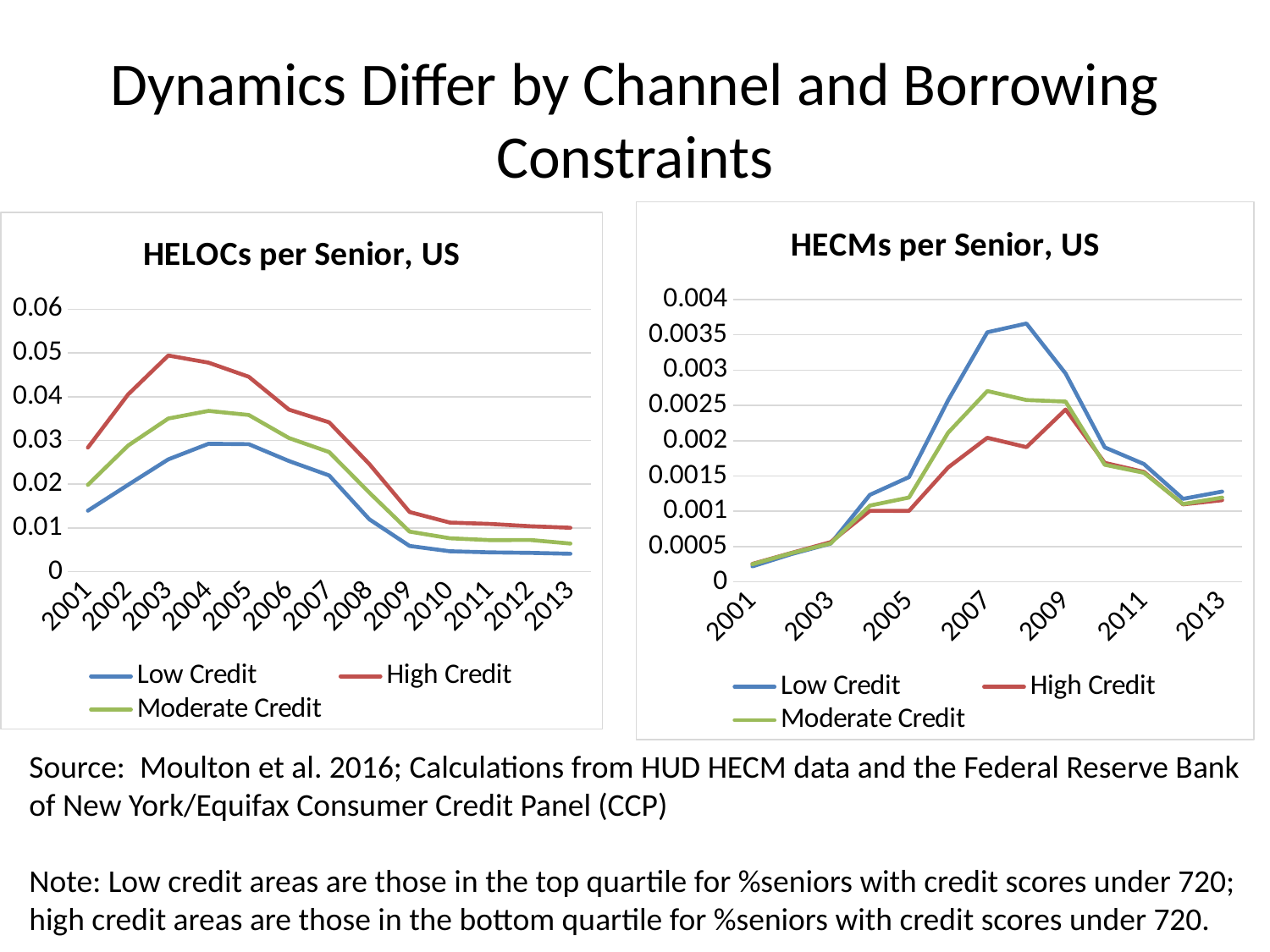
In the "HELOCs per Senior, US" chart, is the value for High Credit in 2003 greater or less than 0.04? greater In the "HECMs per Senior, US" chart, which is larger in 2007, Low Credit or High Credit? Low Credit In the "HELOCs per Senior, US" chart, which series has the highest value in 2003? High Credit In the "HECMs per Senior, US" chart, does the Low Credit series rise or fall from 2001 to 2008? rise In the "HELOCs per Senior, US" chart, is the value for Low Credit in 2001 greater or less than 0.02? less How many series does the legend of the "HECMs per Senior, US" chart list? 3 In the "HELOCs per Senior, US" chart, which series has the lowest value in 2001? Low Credit In the "HELOCs per Senior, US" chart, how many years are shown on the x axis? 13 In the "HECMs per Senior, US" chart, is the value for Low Credit in 2008 greater or less than 0.003? greater In the "HELOCs per Senior, US" chart, does the High Credit series rise or fall from 2005 to 2009? fall What type of chart is the "HELOCs per Senior, US" chart? line chart In the "HECMs per Senior, US" chart, which series has the highest value in 2008? Low Credit